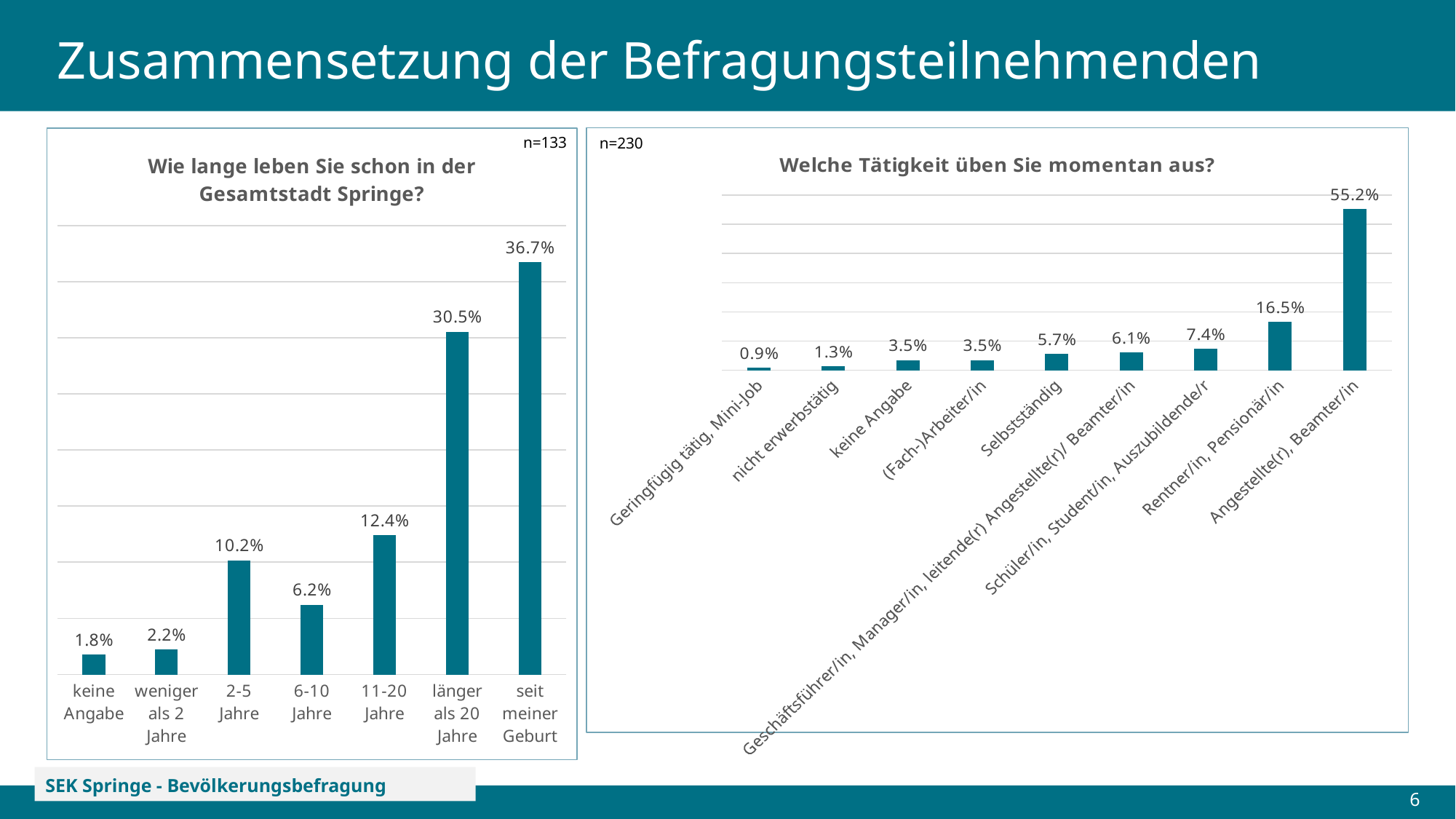
In the chart 'Welche Tätigkeit üben Sie momentan aus?', what is the value for 'Rentner/in, Pensionär/in'? 16.5% In the chart 'Welche Tätigkeit üben Sie momentan aus?', what is the difference between 'Angestellte(r), Beamter/in' and 'Rentner/in, Pensionär/in'? 38.7% In the chart 'Welche Tätigkeit üben Sie momentan aus?', which category has the lowest value? Geringfügig tätig, Mini-Job In the chart 'Wie lange leben Sie schon in der Gesamtstadt Springe?', what is the difference between 'seit meiner Geburt' and 'länger als 20 Jahre'? 6.2% In the chart 'Wie lange leben Sie schon in der Gesamtstadt Springe?', which is larger: '2-5 Jahre' or '6-10 Jahre'? 2-5 Jahre In the chart 'Wie lange leben Sie schon in der Gesamtstadt Springe?', which category has the lowest value? keine Angabe In the chart 'Wie lange leben Sie schon in der Gesamtstadt Springe?', which category has the highest value? seit meiner Geburt What kind of chart is 'Welche Tätigkeit üben Sie momentan aus?'? bar chart In the chart 'Welche Tätigkeit üben Sie momentan aus?', which category has the highest value? Angestellte(r), Beamter/in In the chart 'Wie lange leben Sie schon in der Gesamtstadt Springe?', how many categories are shown? 7 In the chart 'Wie lange leben Sie schon in der Gesamtstadt Springe?', what is the value for '11-20 Jahre'? 12.4% In the chart 'Welche Tätigkeit üben Sie momentan aus?', how many categories are shown? 9